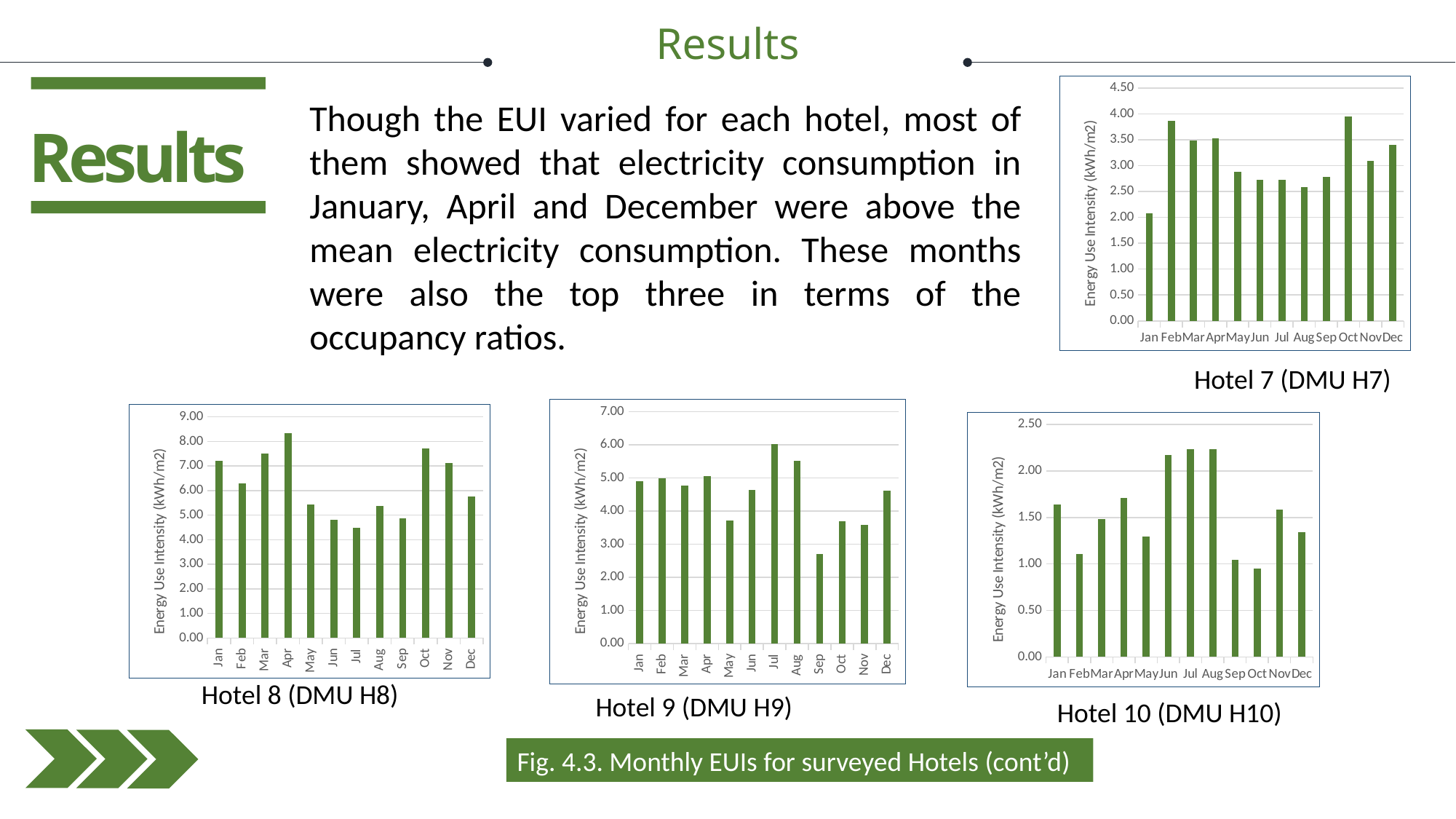
In the Hotel 7 (DMU H7) chart, which month has the lowest energy use intensity? Jan In the Hotel 8 (DMU H8) chart, which month has the larger value, Oct or Dec? Oct In the Hotel 8 (DMU H8) chart, which month has the highest energy use intensity? Apr How many months are plotted in the Hotel 9 (DMU H9) chart? 12 In the Hotel 9 (DMU H9) chart, is the value for Sep greater or less than 3.00? less In the Hotel 10 (DMU H10) chart, which month has the larger value, Jun or Feb? Jun In the Hotel 8 (DMU H8) chart, is the value for Apr greater or less than 8.00? greater In the Hotel 7 (DMU H7) chart, is the value for Jan greater or less than 2.50? less What kind of chart is used for Hotel 7 (DMU H7)? Bar chart In the Hotel 9 (DMU H9) chart, which month has the lowest energy use intensity? Sep In the Hotel 9 (DMU H9) chart, which month has the highest energy use intensity? Jul